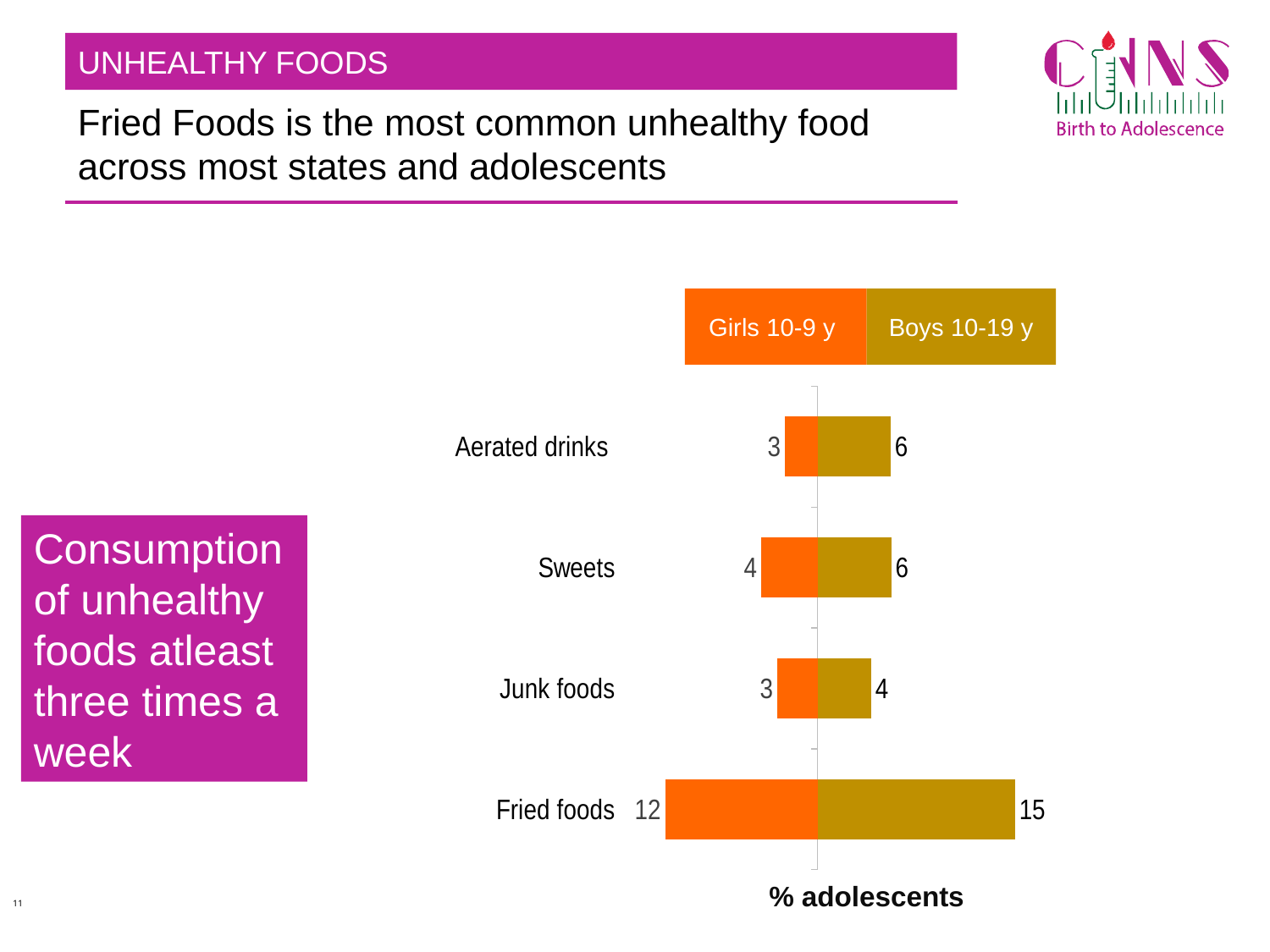
How many food categories are shown in the chart? 4 What is the value for Girls 10-9 y for Sweets? 4 What is the difference between the Boys 10-19 y and Girls 10-9 y values for Fried foods? 3 What is the label of the horizontal axis of the chart? % adolescents What is the value for Boys 10-19 y for Fried foods? 15 What is the value for Boys 10-19 y for Junk foods? 4 How many series does the legend list? 2 Which food category has the highest value for Boys 10-19 y? Fried foods Which is larger for Sweets: the Girls 10-9 y value or the Boys 10-19 y value? Boys 10-19 y What is the value for Girls 10-9 y for Aerated drinks? 3 What kind of chart is shown on the slide? Bar chart Which food category has the lowest value for Girls 10-9 y? Aerated drinks and Junk foods (both 3)